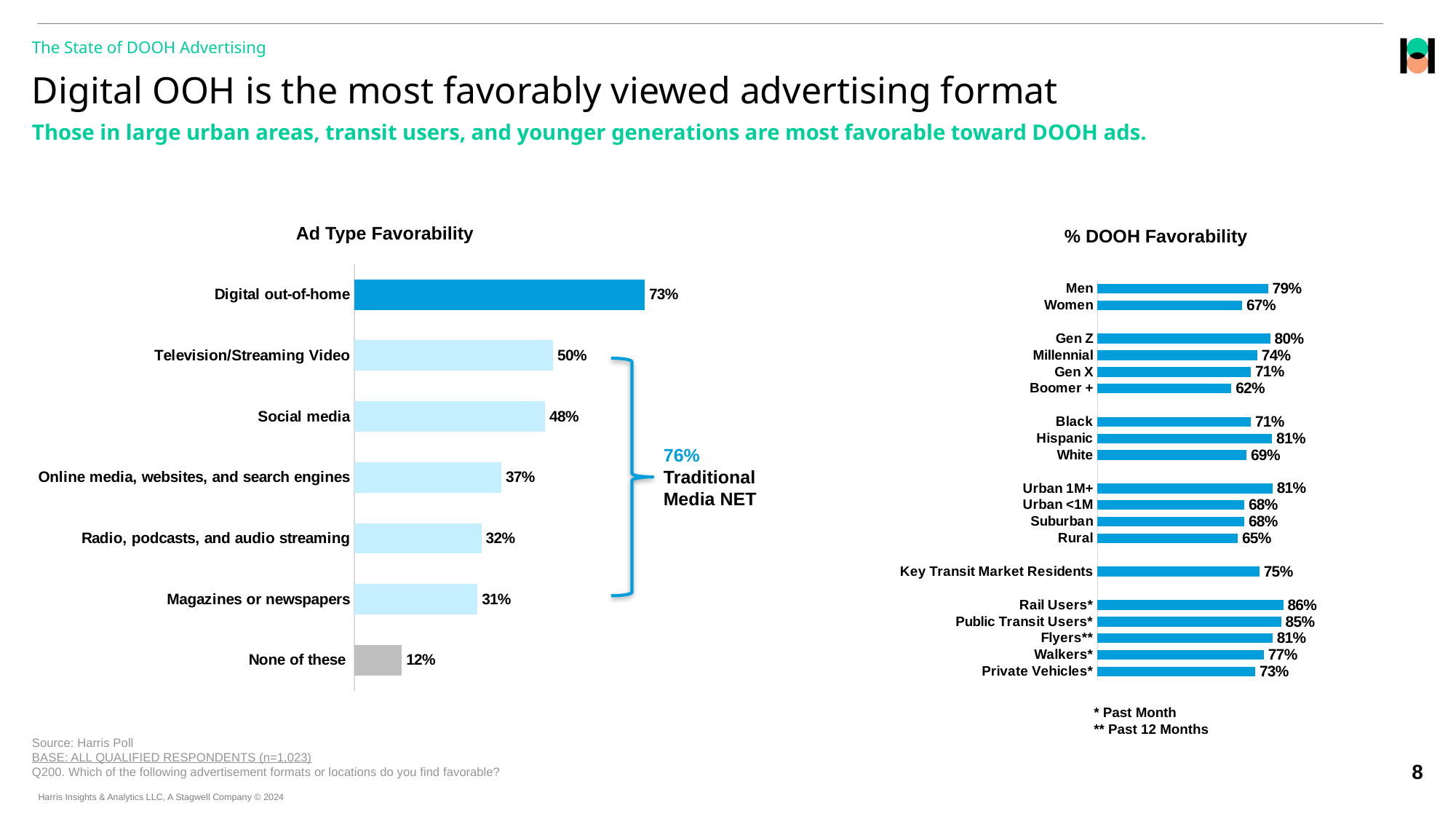
In the Ad Type Favorability chart, how many categories are shown? 7 In the Ad Type Favorability chart, what is the difference between Television/Streaming Video and Magazines or newspapers? 19% In the % DOOH Favorability chart, which is larger, Men or Women? Men In the Ad Type Favorability chart, what is the Traditional Media NET value shown next to the bracket? 76% In the % DOOH Favorability chart, which category has the highest value? Rail Users* What type of chart is the % DOOH Favorability chart? Bar chart In the Ad Type Favorability chart, what is the value for Digital out-of-home? 73% In the % DOOH Favorability chart, what is the value for Key Transit Market Residents? 75% In the % DOOH Favorability chart, what is the difference between Urban 1M+ and Rural? 16% In the Ad Type Favorability chart, which category has the lowest value? None of these In the Ad Type Favorability chart, what is the value for Social media? 48% In the % DOOH Favorability chart, what is the value for Gen Z? 80%